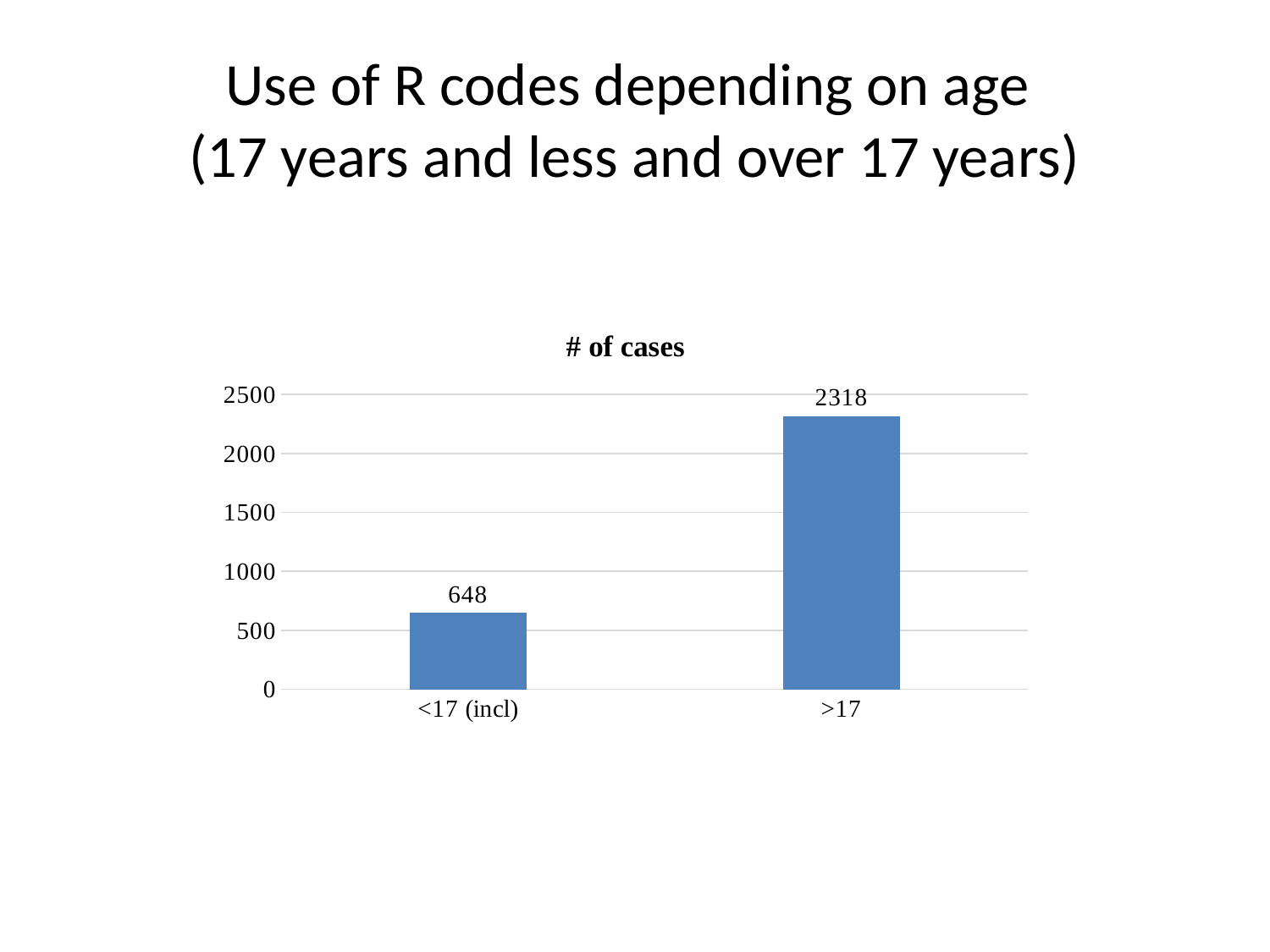
What is the number of cases for the <17 (incl) age group? 648 What is the number of cases for the >17 age group? 2318 Which group has more cases, <17 (incl) or >17? >17 What is the total number of cases across both age groups? 2966 What is the difference in the number of cases between the >17 and <17 (incl) groups? 1670 Is the value for <17 (incl) greater or less than 1000? less What kind of chart is shown on the slide? bar chart Is the value for >17 greater or less than 2000? greater Which age group has the lowest number of cases? <17 (incl) What is the title of the chart? # of cases Which age group has the highest number of cases? >17 How many age categories are shown on the chart? 2